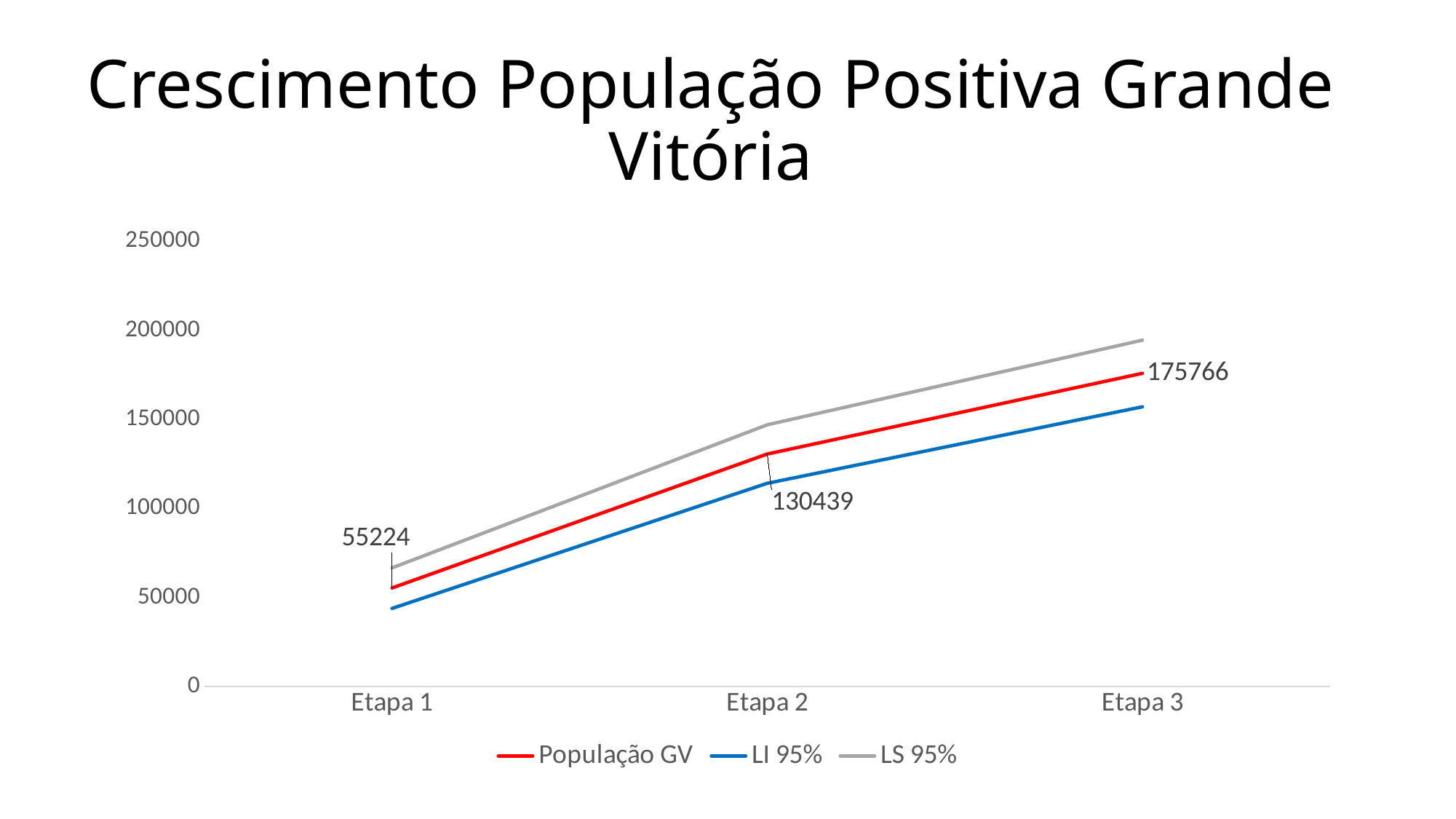
What is the value of População GV at Etapa 1? 55224 How many series does the legend list? 3 At which Etapa is População GV lowest? Etapa 1 Is the value of LS 95% at Etapa 3 greater or less than 200000? less What is the difference between População GV at Etapa 2 and at Etapa 1? 75215 What is the difference between População GV at Etapa 3 and at Etapa 1? 120542 What is the value of População GV at Etapa 2? 130439 At which Etapa is População GV highest? Etapa 3 Does População GV rise or fall from Etapa 1 to Etapa 3? rise What is the value of População GV at Etapa 3? 175766 Is the value of LI 95% at Etapa 1 greater or less than 50000? less What kind of chart is shown on the slide? line chart